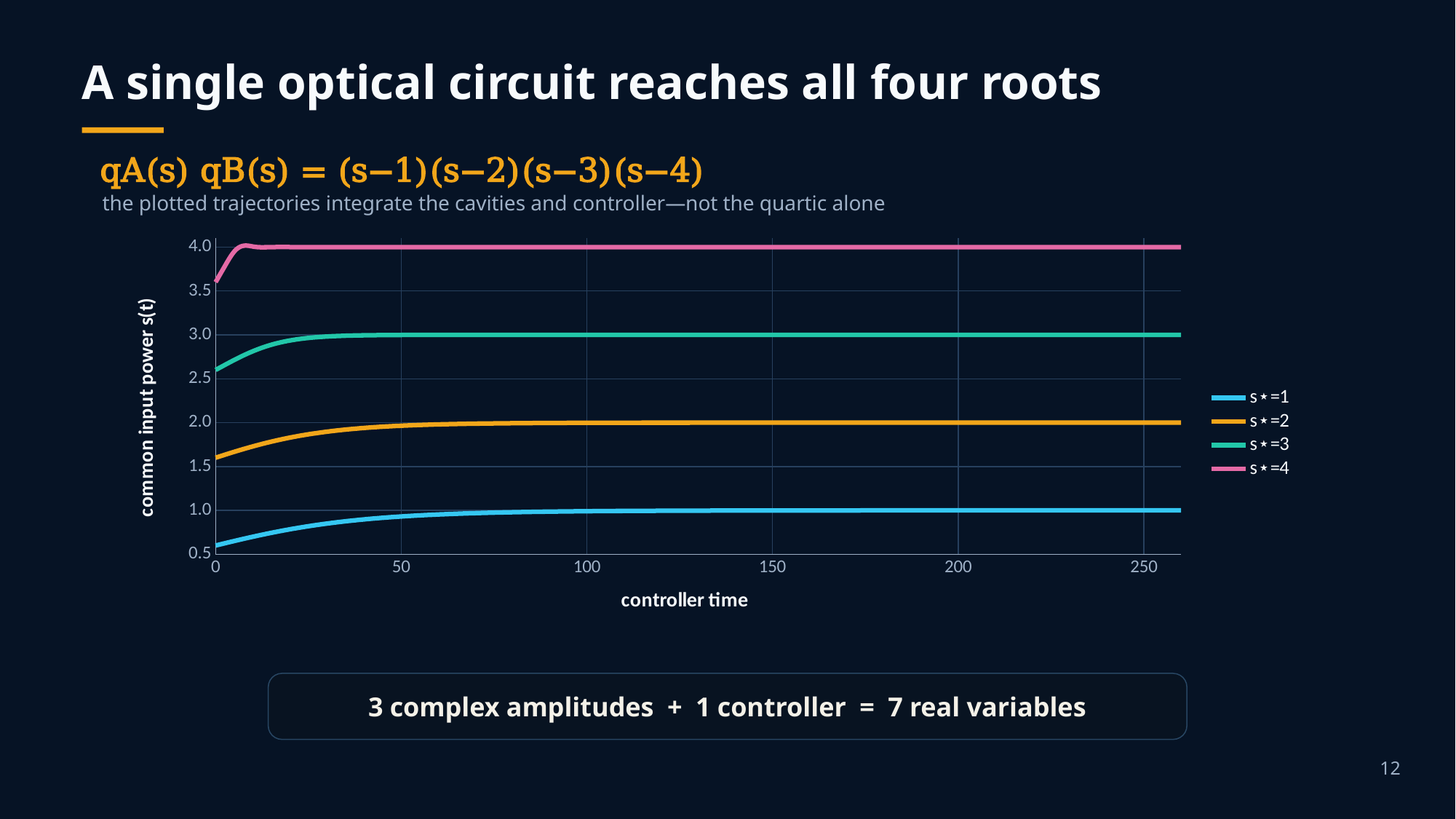
Which series has the lowest value at controller time 250? s*=1 What kind of chart is shown on the slide? line chart Which is larger at controller time 200: the value for s*=3 or the value for s*=2? s*=3 What is the label of the x axis? controller time Which series has the highest value at controller time 250? s*=4 Does the s*=1 series rise or fall as controller time increases from 0 to 50? rise What is the difference between the settled values of s*=4 and s*=1 at controller time 250? 3.0 How many series does the legend list? 4 What value does the s*=4 series settle at by controller time 250? 4.0 Is the value for s*=3 at controller time 0 greater or less than 3.0? less What value does the s*=2 series settle at by controller time 250? 2.0 Is the value for s*=1 at controller time 0 greater or less than 1.0? less